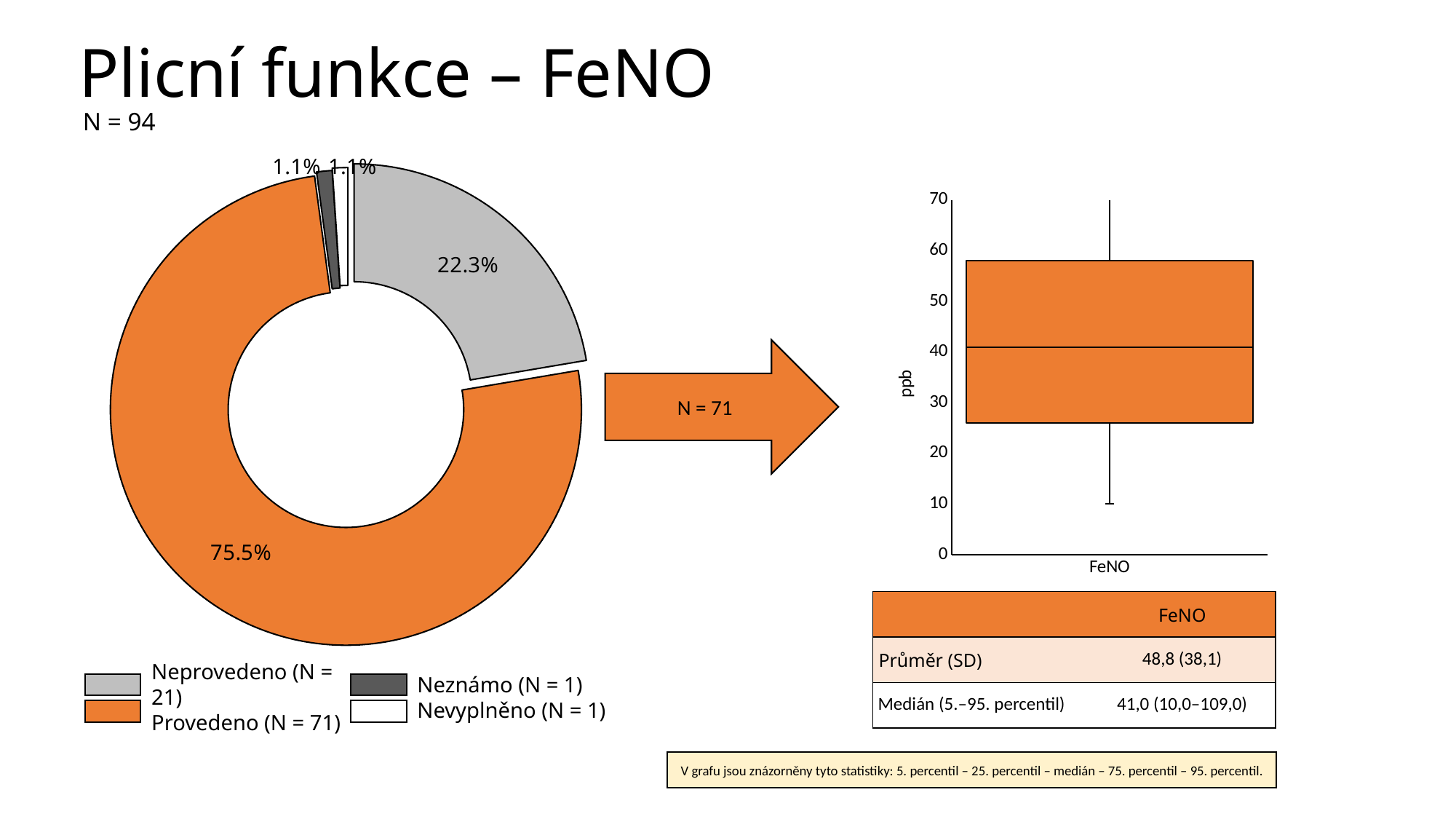
What kind of chart is the chart on the left of the slide? Pie chart (donut) In the pie chart on the left, what N is given in the legend for Neprovedeno? N = 21 In the pie chart on the left, what share does the Neznámo slice have? 1.1% In the pie chart on the left, what share does the Provedeno slice have? 75.5% In the pie chart on the left, how many categories does the legend list? 4 In the box plot on the right, what is the label of the y axis? ppb In the pie chart on the left, what share does the Neprovedeno slice have? 22.3% In the pie chart on the left, which is larger, the Neprovedeno slice or the Provedeno slice? Provedeno In the pie chart on the left, what is the difference in percentage points between the Provedeno and Neprovedeno slices? 53.2 percentage points In the pie chart on the left, which category has the largest slice? Provedeno In the box plot on the right, is the median line for FeNO greater or less than 30? greater In the pie chart on the left, what colour is the Provedeno slice? Orange